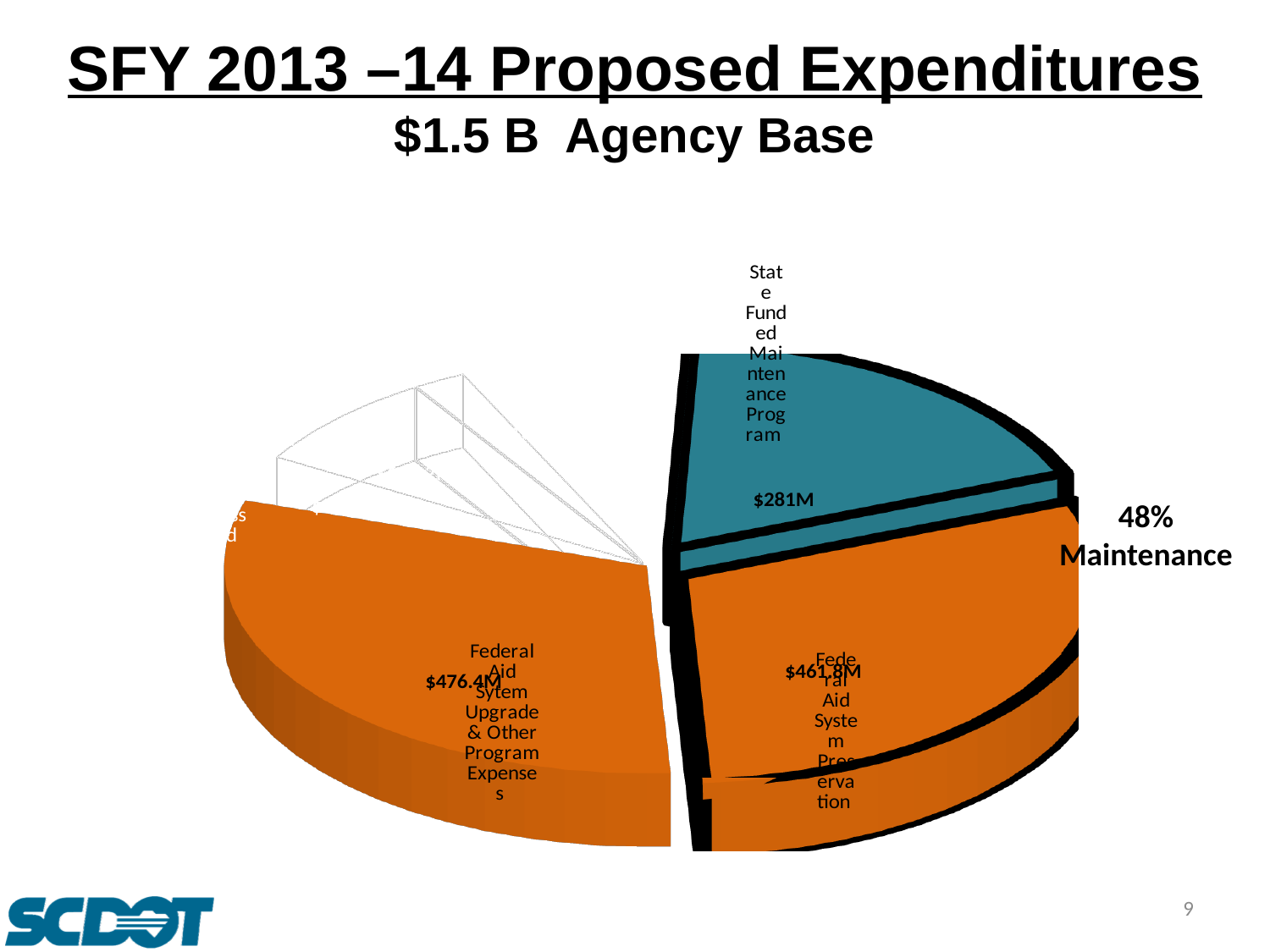
What is the value shown for the Federal Aid System Upgrade & Other Program Expenses slice? $476.4M What percentage is labelled as Maintenance next to the chart? 48% What agency base amount is stated in the slide subtitle? $1.5 B What is the value shown for the Federal Aid System Preservation slice? $461.8M Which slice has the largest value shown on the chart? Federal Aid System Upgrade & Other Program Expenses What is the difference between the Federal Aid System Upgrade & Other Program Expenses value and the State Funded Maintenance Program value? $195.4M What is the difference between the Federal Aid System Preservation value and the State Funded Maintenance Program value? $180.8M Which is larger: Federal Aid System Upgrade & Other Program Expenses or Federal Aid System Preservation? Federal Aid System Upgrade & Other Program Expenses Which is larger: Federal Aid System Preservation or State Funded Maintenance Program? Federal Aid System Preservation What is the value shown for the State Funded Maintenance Program slice? $281M What kind of chart is shown on the slide? Pie chart What is the difference between the Federal Aid System Upgrade & Other Program Expenses value and the Federal Aid System Preservation value? $14.6M